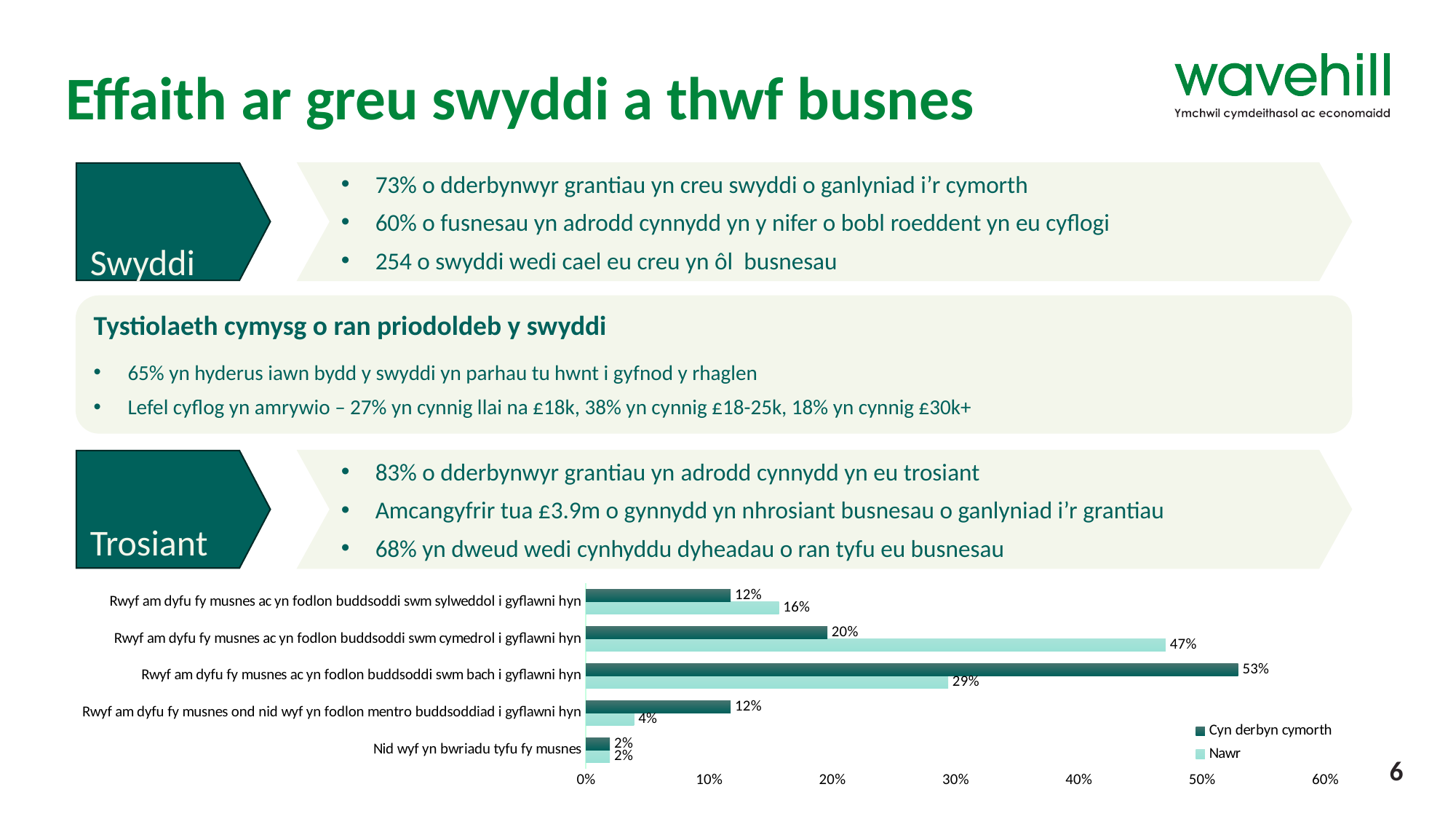
For 'Rwyf am dyfu fy musnes ac yn fodlon buddsoddi swm sylweddol i gyflawni hyn', which is larger: 'Cyn derbyn cymorth' or 'Nawr'? Nawr What is the 'Nawr' value for 'Rwyf am dyfu fy musnes ond nid wyf yn fodlon mentro buddsoddiad i gyflawni hyn'? 4% What is the 'Nawr' value for 'Rwyf am dyfu fy musnes ac yn fodlon buddsoddi swm cymedrol i gyflawni hyn'? 47% What is the 'Cyn derbyn cymorth' value for 'Rwyf am dyfu fy musnes ac yn fodlon buddsoddi swm bach i gyflawni hyn'? 53% Which category has the highest 'Cyn derbyn cymorth' value? Rwyf am dyfu fy musnes ac yn fodlon buddsoddi swm bach i gyflawni hyn What kind of chart is shown at the bottom of the slide? Bar chart How many series does the chart legend list? 2 Is the 'Cyn derbyn cymorth' value for 'Rwyf am dyfu fy musnes ac yn fodlon buddsoddi swm bach i gyflawni hyn' greater or less than 50%? greater Which category has the lowest 'Nawr' value? Nid wyf yn bwriadu tyfu fy musnes How many categories are shown on the chart? 5 What is the difference between the 'Nawr' and 'Cyn derbyn cymorth' values for 'Rwyf am dyfu fy musnes ac yn fodlon buddsoddi swm cymedrol i gyflawni hyn'? 27% What are the two series names listed in the chart legend? Cyn derbyn cymorth and Nawr